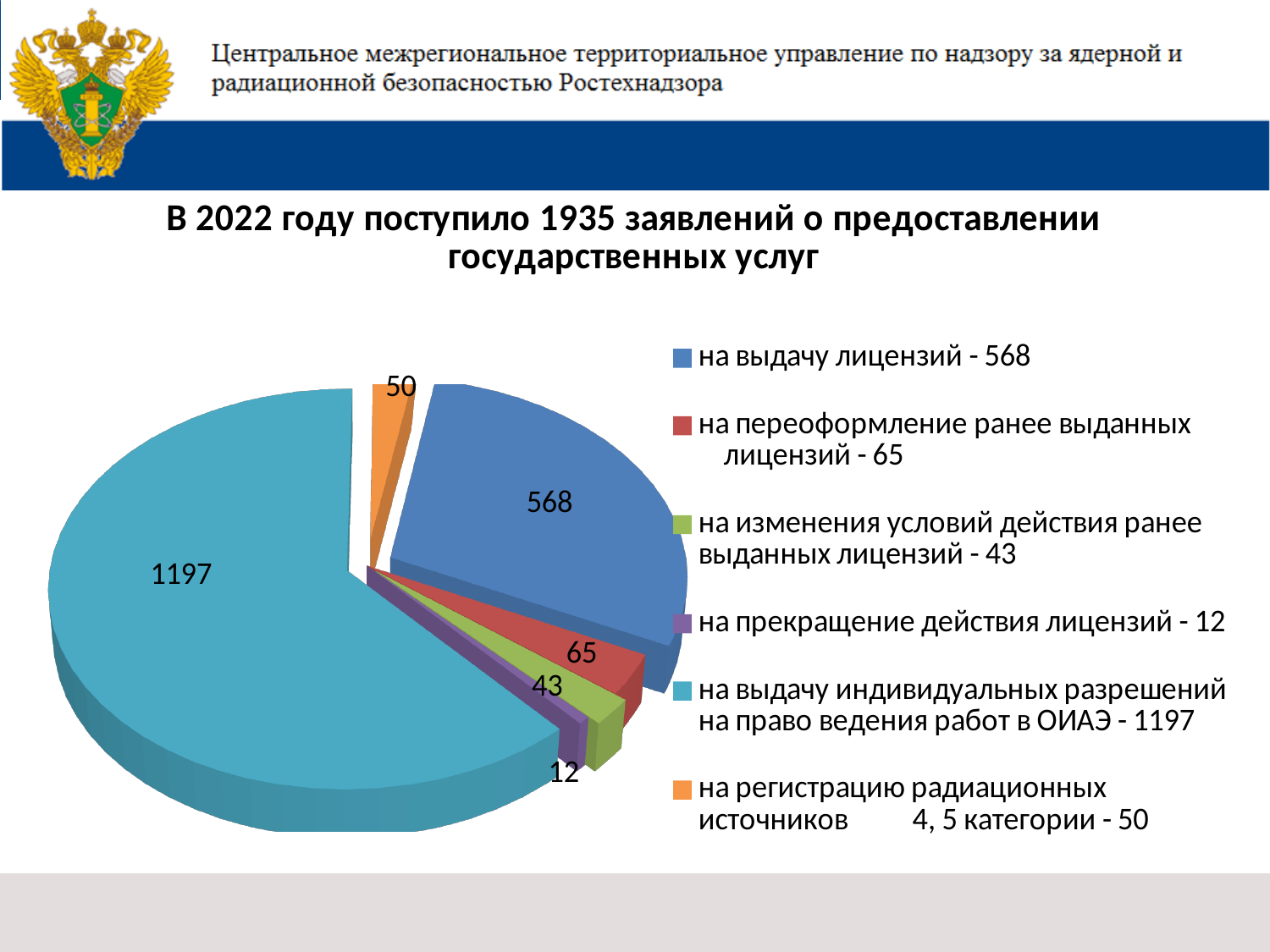
Which category has the largest slice in the pie chart? на выдачу индивидуальных разрешений на право ведения работ в ОИАЭ What colour is the slice for 'на регистрацию радиационных источников 4, 5 категории'? orange What is the difference between the value for 'на выдачу индивидуальных разрешений на право ведения работ в ОИАЭ' and the value for 'на выдачу лицензий'? 629 How many entries does the legend of the pie chart list? 6 Which is larger: the value for 'на переоформление ранее выданных лицензий' or the value for 'на изменения условий действия ранее выданных лицензий'? на переоформление ранее выданных лицензий What is the value for 'на регистрацию радиационных источников 4, 5 категории'? 50 How many slices does the pie chart have? 6 What is the value for 'на прекращение действия лицензий'? 12 What type of chart is shown on the slide? pie chart Which category has the smallest slice in the pie chart? на прекращение действия лицензий What is the value for 'на переоформление ранее выданных лицензий'? 65 What is the value for 'на выдачу лицензий' in the pie chart? 568